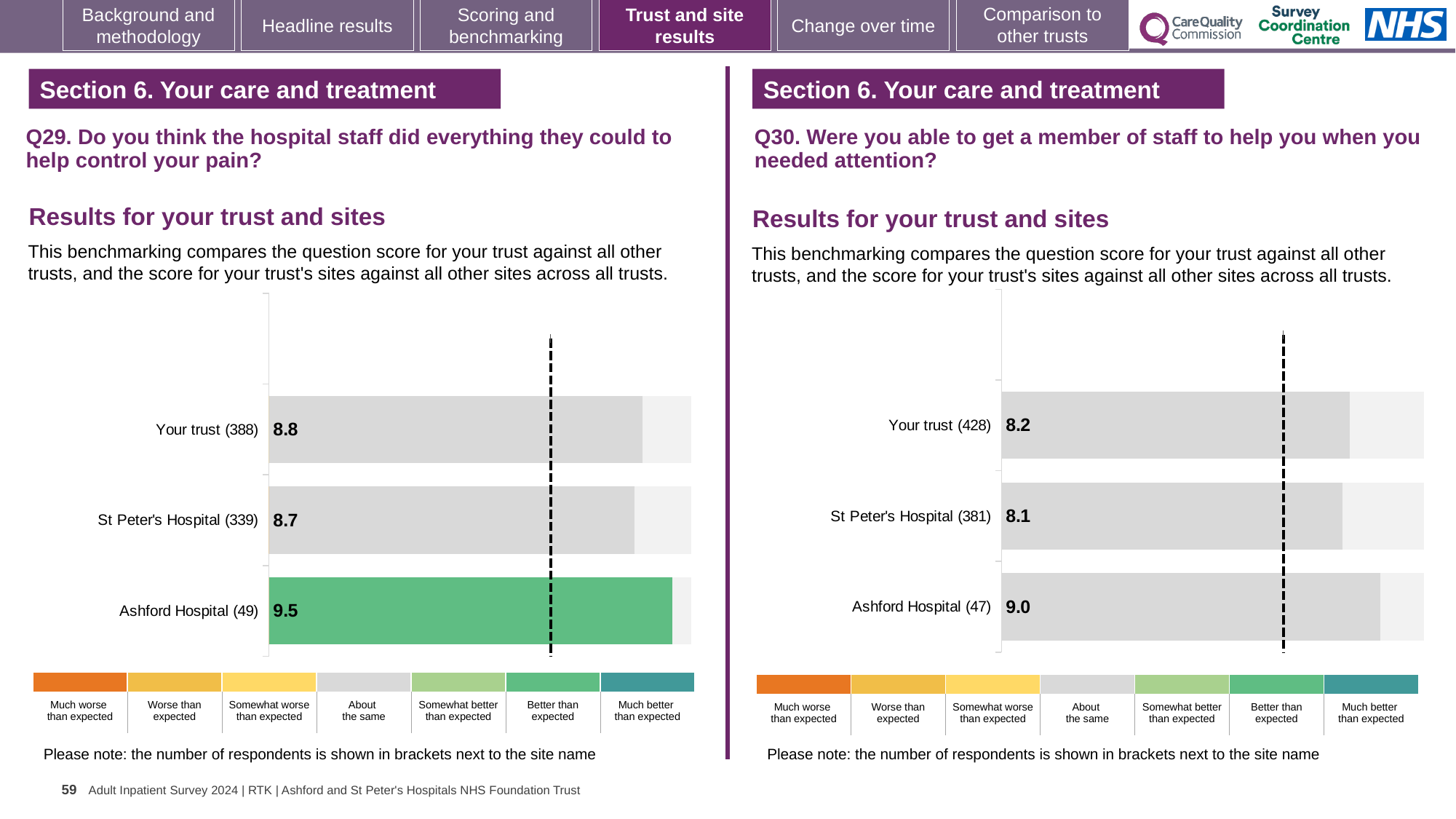
On the Q30 chart (right), which site or trust has the lowest score? St Peter's Hospital What type of chart is used on the Q30 chart (right)? Bar chart On the Q29 chart (left), what is the score for Ashford Hospital? 9.5 On the Q29 chart (left), which bar is coloured green rather than grey? Ashford Hospital How many bars are shown on the Q29 chart (left)? 3 On the Q30 chart (right), which has the larger score, Your trust or Ashford Hospital? Ashford Hospital On the Q30 chart (right), what is the score for Ashford Hospital? 9.0 On the Q30 chart (right), what is the score for St Peter's Hospital? 8.1 On the Q29 chart (left), which site or trust has the highest score? Ashford Hospital On the Q29 chart (left), what is the difference between the scores for Ashford Hospital and St Peter's Hospital? 0.8 On the Q29 chart (left), what is the score for Your trust? 8.8 On the Q30 chart (right), what is the difference between the scores for Ashford Hospital and Your trust? 0.8